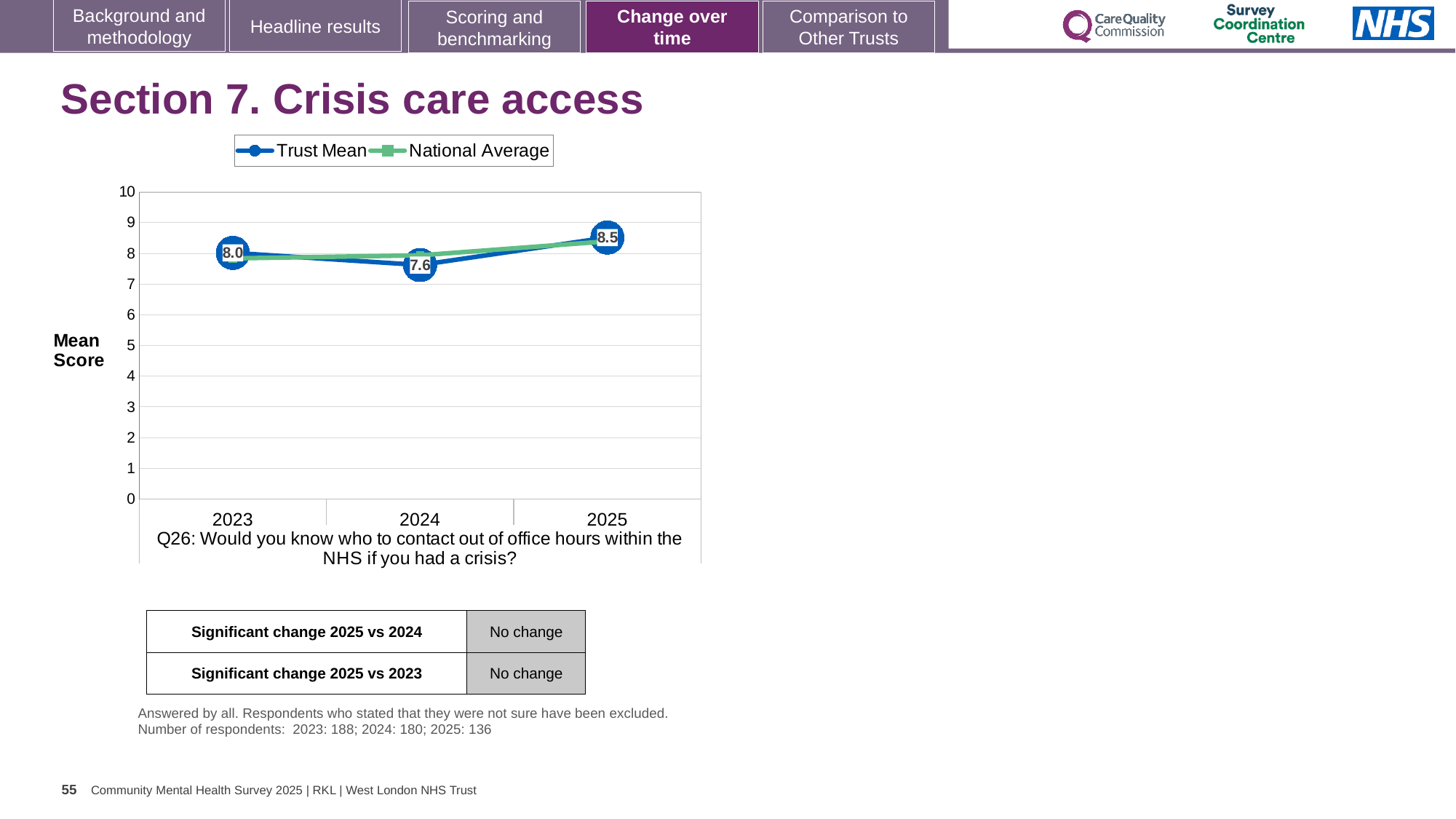
What is the Trust Mean score for 2024? 7.6 In which year is the Trust Mean lowest? 2024 What is the label of the y axis? Mean Score What is the Trust Mean score for 2023? 8.0 What kind of chart is shown on the slide? Line chart How many years are plotted on the x axis? 3 In which year is the Trust Mean highest? 2025 Is the National Average value for 2025 greater or less than 8? greater How many series does the legend list? 2 What is the difference between the Trust Mean in 2025 and in 2024? 0.9 Which is larger, the Trust Mean in 2023 or in 2025? 2025 What is the Trust Mean score for 2025? 8.5